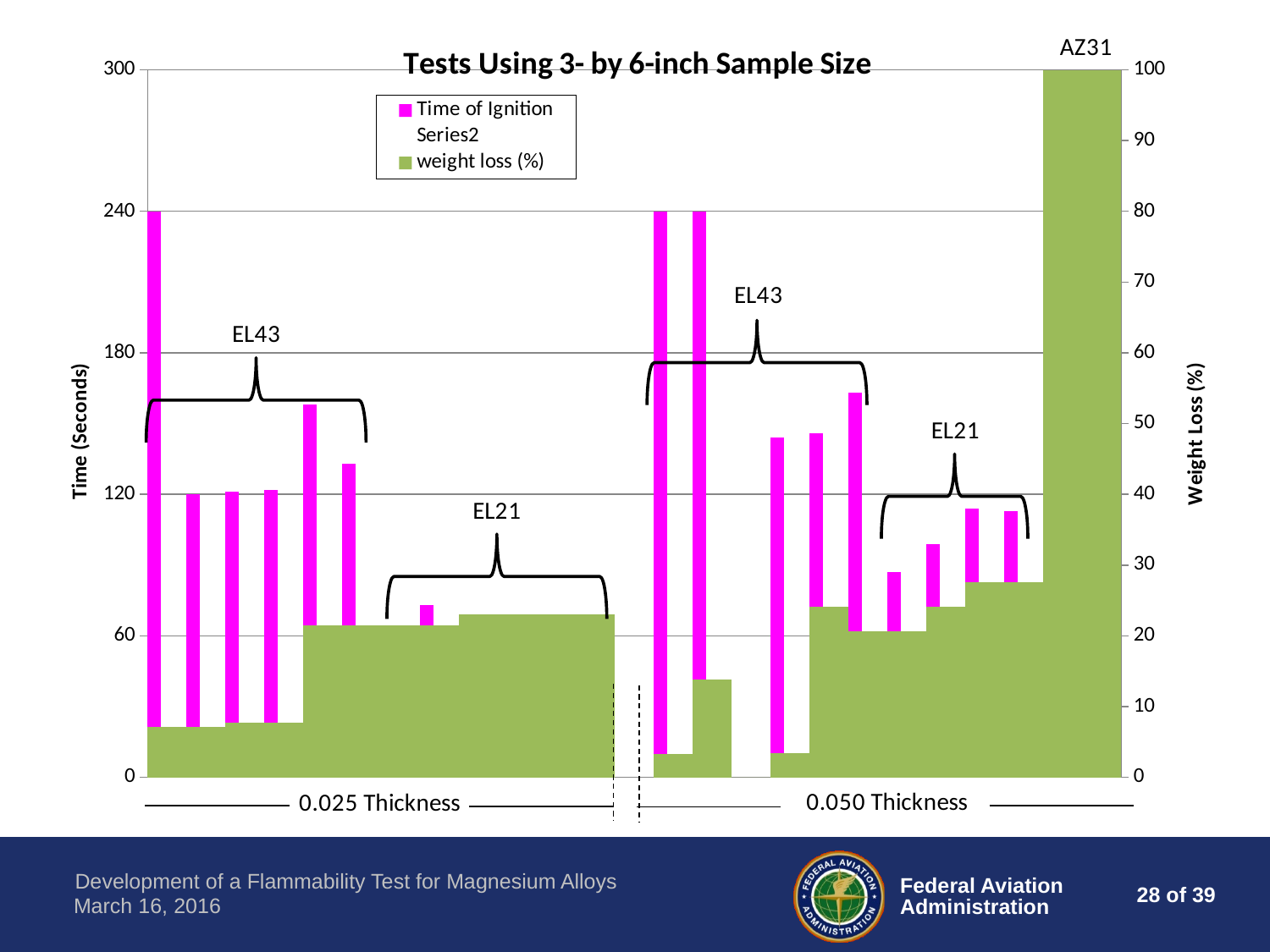
Are the weight loss (%) values for EL21 at 0.025 Thickness greater or less than 30? less What kind of chart is shown on the slide? bar chart How many thickness groups are labeled along the x axis? 2 What is the title of the chart? Tests Using 3- by 6-inch Sample Size Is the Time of Ignition for the first EL43 bar at 0.025 Thickness greater or less than 180 seconds? greater Is the weight loss (%) for AZ31 greater or less than 90? greater Which alloy has the highest weight loss (%) on the chart? AZ31 What is the label of the left vertical axis? Time (Seconds) What is the weight loss (%) for AZ31? 100 How many series does the chart legend list? 3 Which has the higher weight loss (%): AZ31 or EL21 at 0.050 Thickness? AZ31